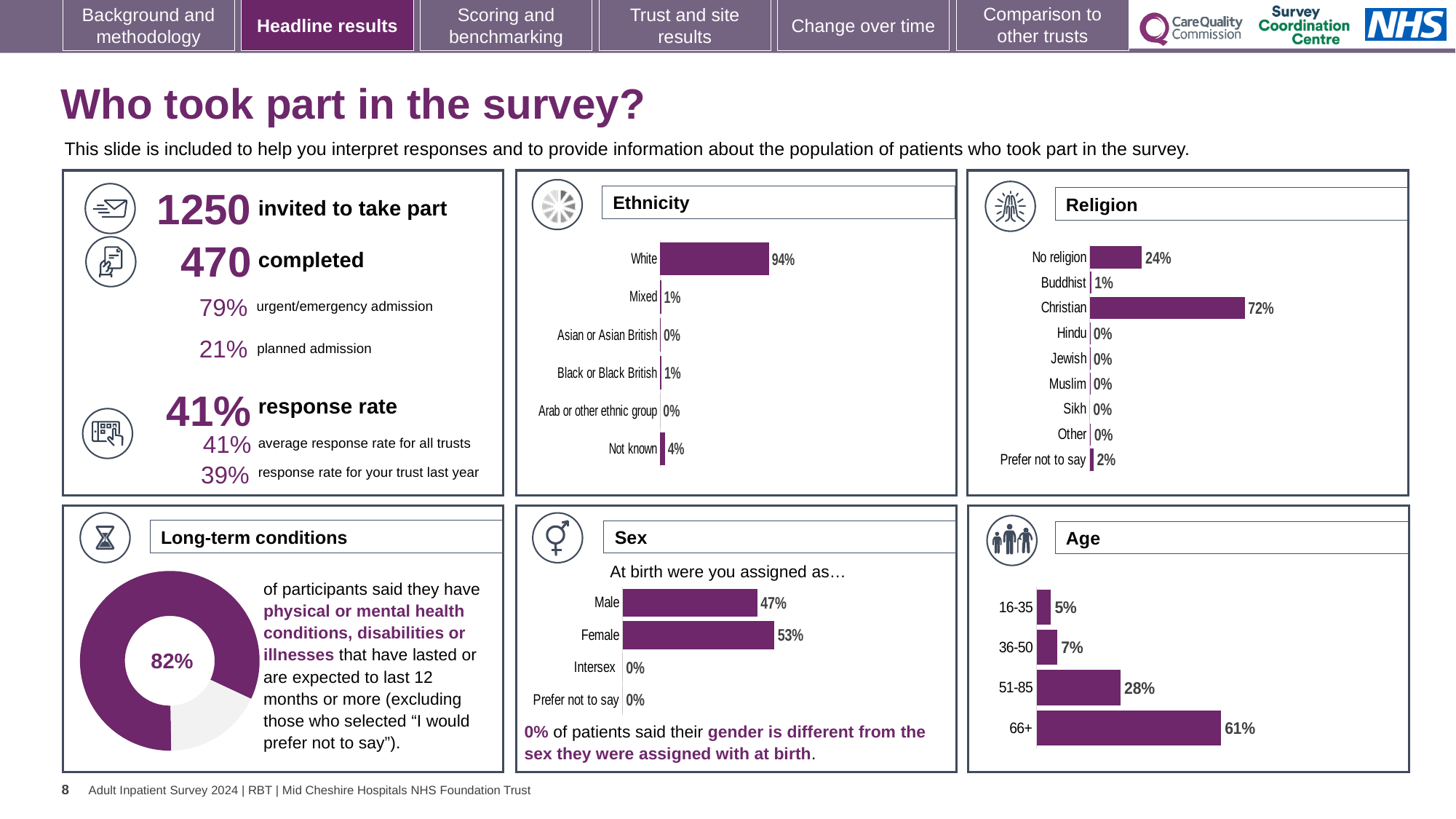
In the Sex chart, what is the difference between Female and Male? 6% How many categories are shown in the Religion chart? 9 In the Age chart, which age group has the highest value? 66+ In the Age chart, what is the value for 51-85? 28% In the Religion chart, what is the value for No religion? 24% In the Religion chart, what is the difference between Christian and No religion? 48% In the Religion chart, which category has the highest value? Christian In the Age chart, which age group has the lowest value? 16-35 In the Ethnicity chart, what is the value for Not known? 4% In the Sex chart, which is larger, Male or Female? Female In the Ethnicity chart, what percentage of respondents are White? 94% What kind of chart is the Long-term conditions chart? Doughnut chart